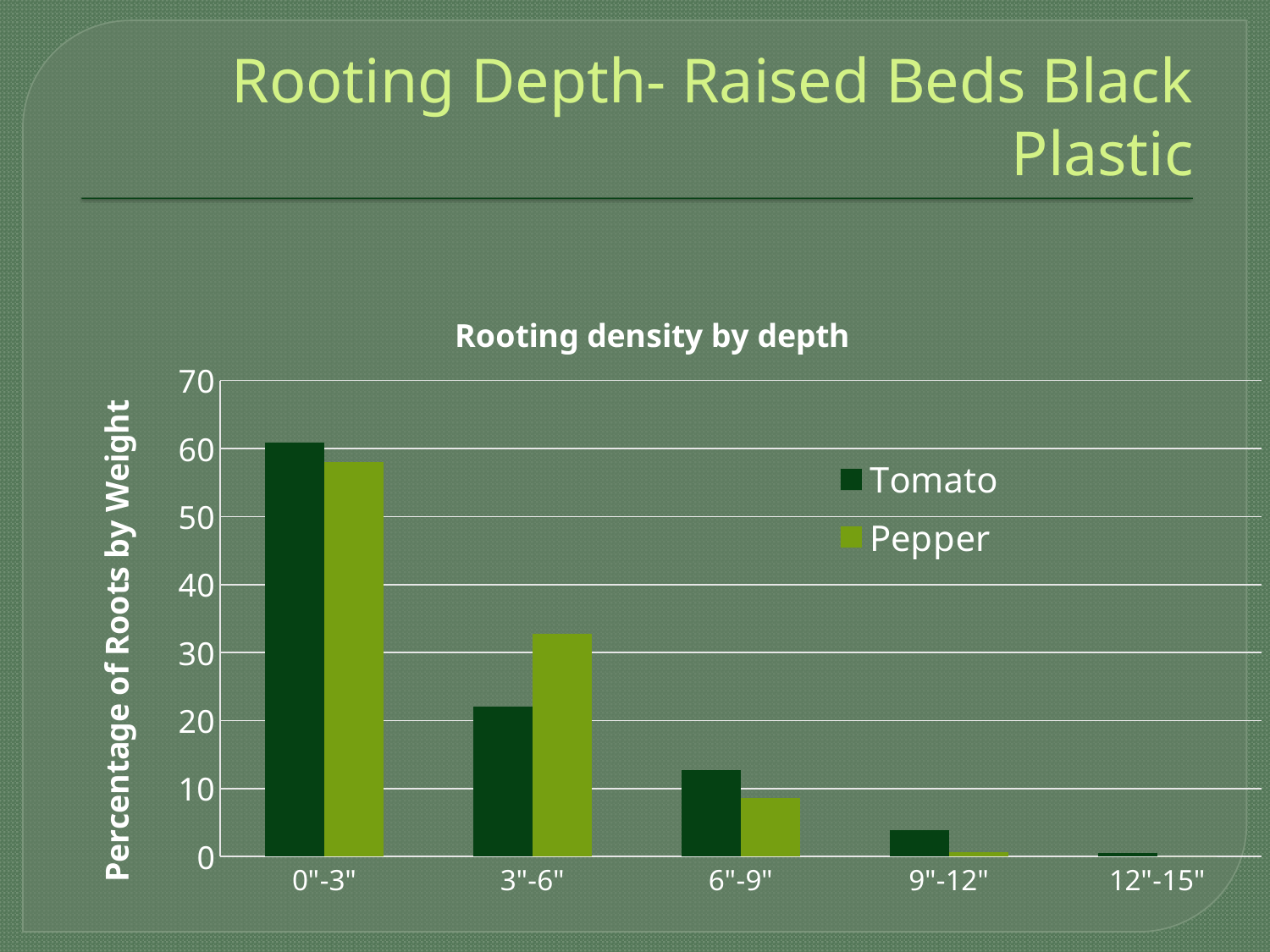
At the 0"-3" depth, which series has the larger value, Tomato or Pepper? Tomato Do the Tomato values rise or fall as depth increases along the x axis? fall Which depth category has the lowest value for Tomato? 12"-15" Is the value for Pepper at 3"-6" greater or less than 30? greater How many series does the legend list? 2 What is the title of the chart? Rooting density by depth Is the value for Tomato at 3"-6" greater or less than 30? less Is the value for Tomato at 0"-3" greater or less than 50? greater How many depth categories are shown on the x axis? 5 What kind of chart is shown on the slide? bar chart Which depth category has the highest value for Tomato? 0"-3" At the 3"-6" depth, which series has the larger value, Tomato or Pepper? Pepper